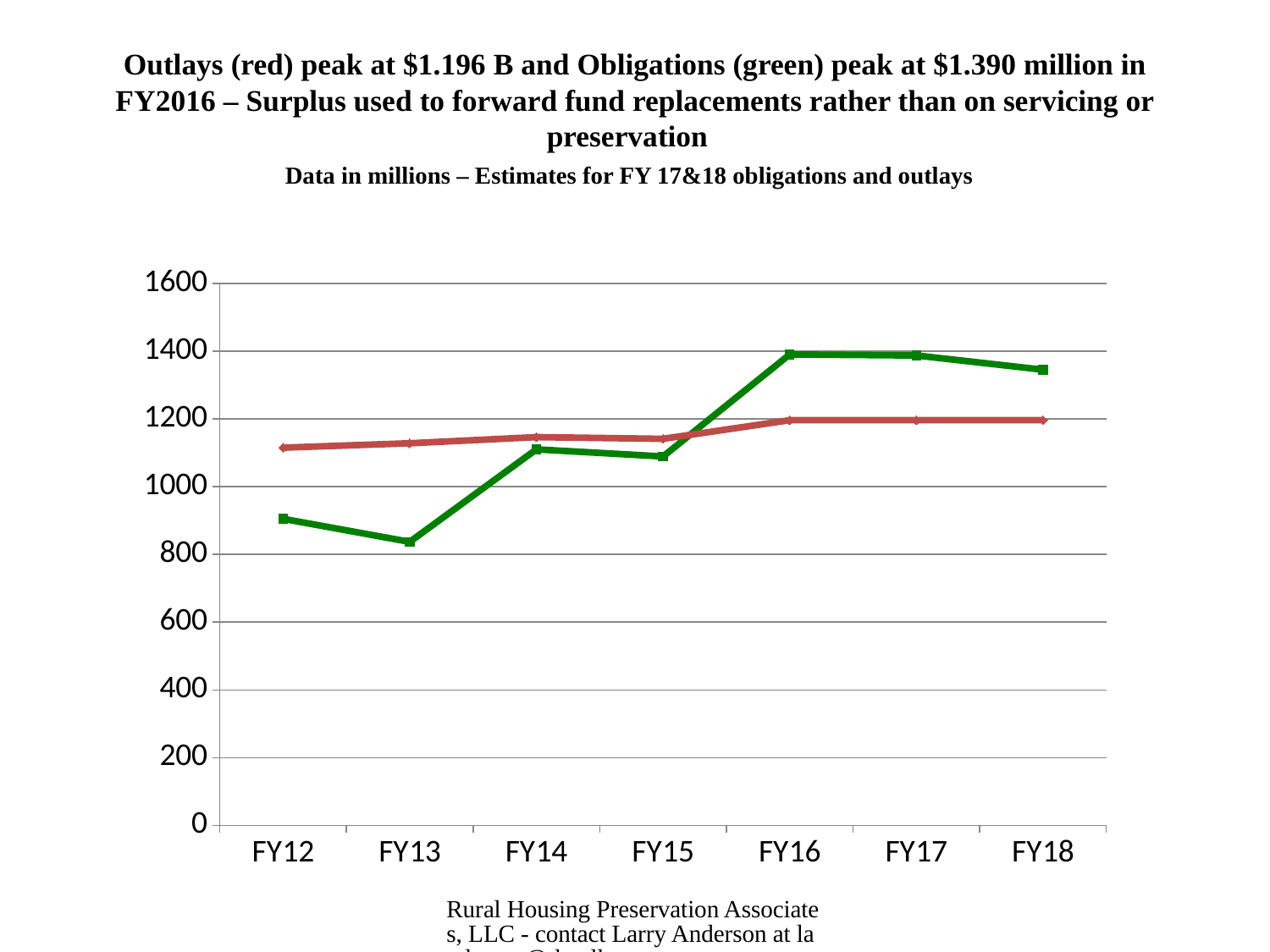
Is the value of the green (Obligations) line for FY18 greater or less than 1200? greater How many lines (series) are plotted on the chart? 2 According to the slide title, which colour represents Outlays? Red In FY12, which line is higher, the red (Outlays) or the green (Obligations)? Red (Outlays) In which fiscal year is the green (Obligations) line at its lowest? FY13 Is the value of the red (Outlays) line for FY16 greater or less than 1400? less Does the green (Obligations) line rise or fall from FY15 to FY16? Rise Is the value of the green (Obligations) line for FY13 greater or less than 1000? less How many fiscal years are plotted along the x axis? 7 What kind of chart is shown on the slide? Line chart In FY16, which line is higher, the red (Outlays) or the green (Obligations)? Green (Obligations)